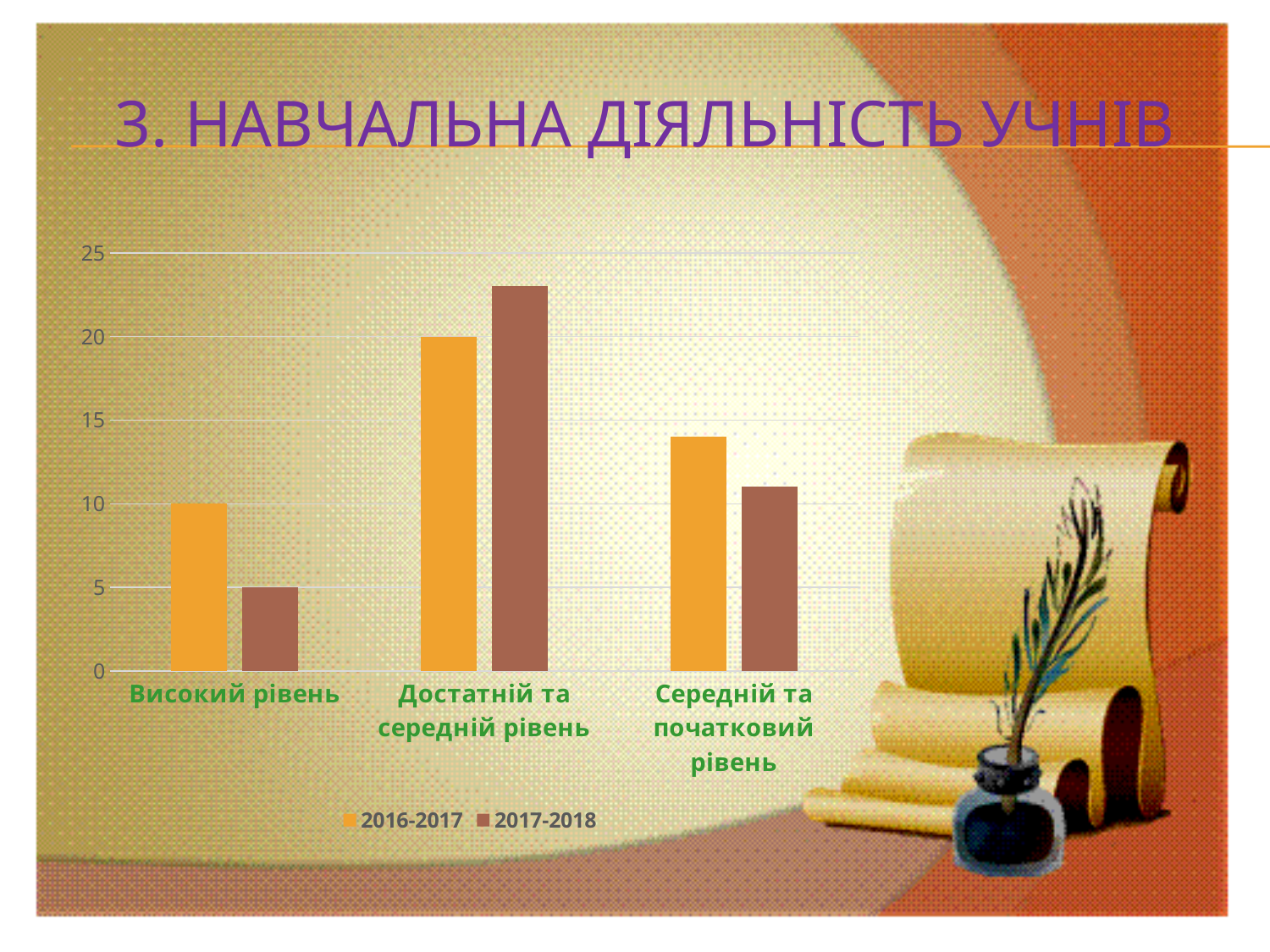
How many series does the legend list? 2 Which category has the lowest value in the 2016-2017 series? Високий рівень What is the difference between the 2016-2017 and 2017-2018 values for Високий рівень? 5 What is the value for Високий рівень in the 2016-2017 series? 10 What is the value for Високий рівень in the 2017-2018 series? 5 Is the 2017-2018 value for Достатній та середній рівень greater or less than 20? greater How many categories are shown on the x axis? 3 What is the value for Достатній та середній рівень in the 2016-2017 series? 20 What kind of chart is shown on the slide? bar chart For Середній та початковий рівень, which series has the larger value, 2016-2017 or 2017-2018? 2016-2017 Is the 2016-2017 value for Середній та початковий рівень greater or less than 15? less Which category has the highest value in the 2017-2018 series? Достатній та середній рівень